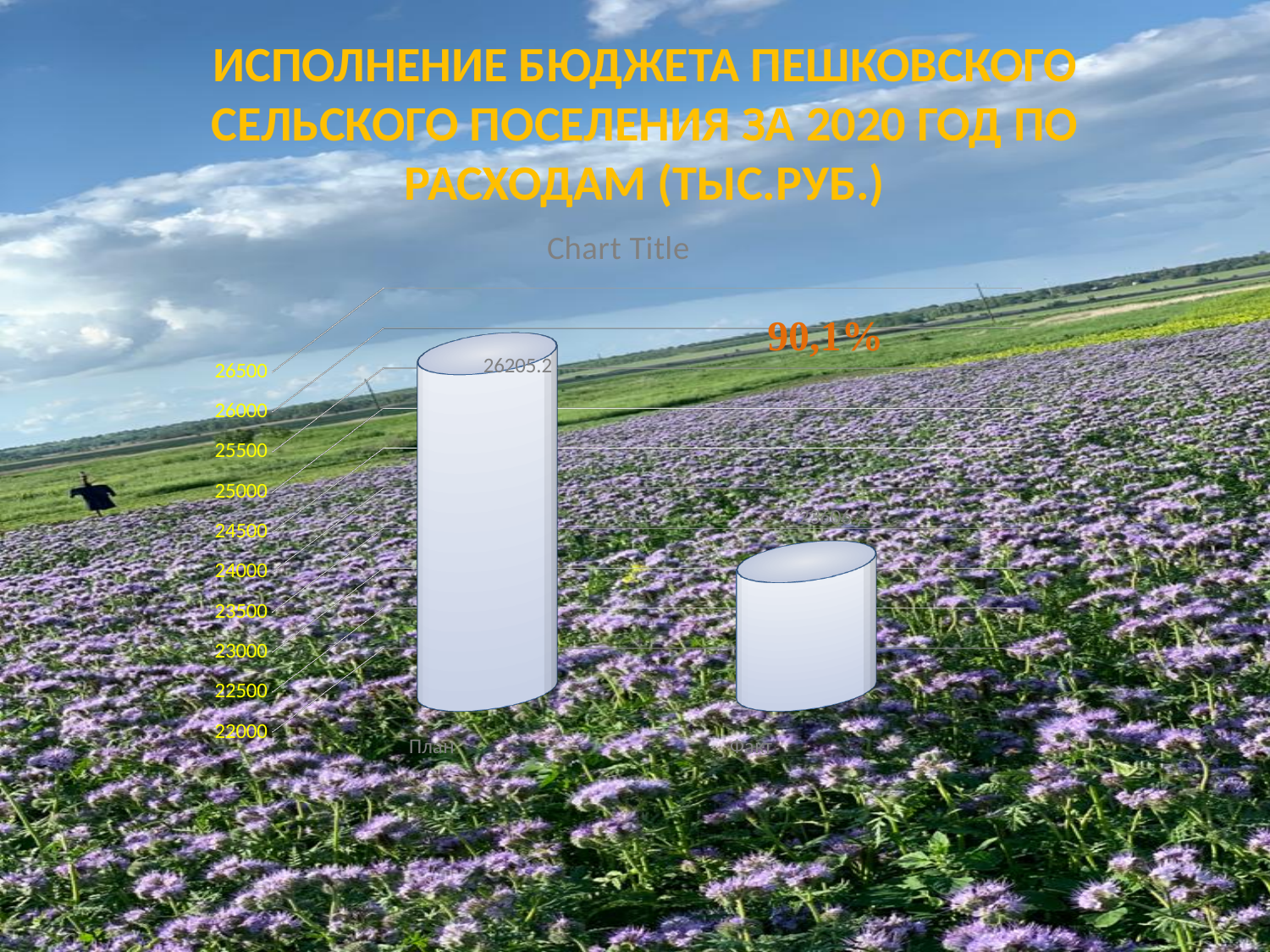
Which is larger, the value for План or the value for Факт? План Is the value for План greater or less than 26000? greater Is the value for Факт greater or less than 23000? greater Do the values rise or fall from План to Факт? fall What is the title printed directly above the chart area? Chart Title Which category has the lowest value? Факт What is the value shown for План? 26205.2 How many categories are plotted on the chart? 2 What kind of chart is shown on the slide? bar chart Is the value for Факт greater or less than 25000? less What percentage is written as an annotation above the chart? 90,1% Which category has the highest value? План